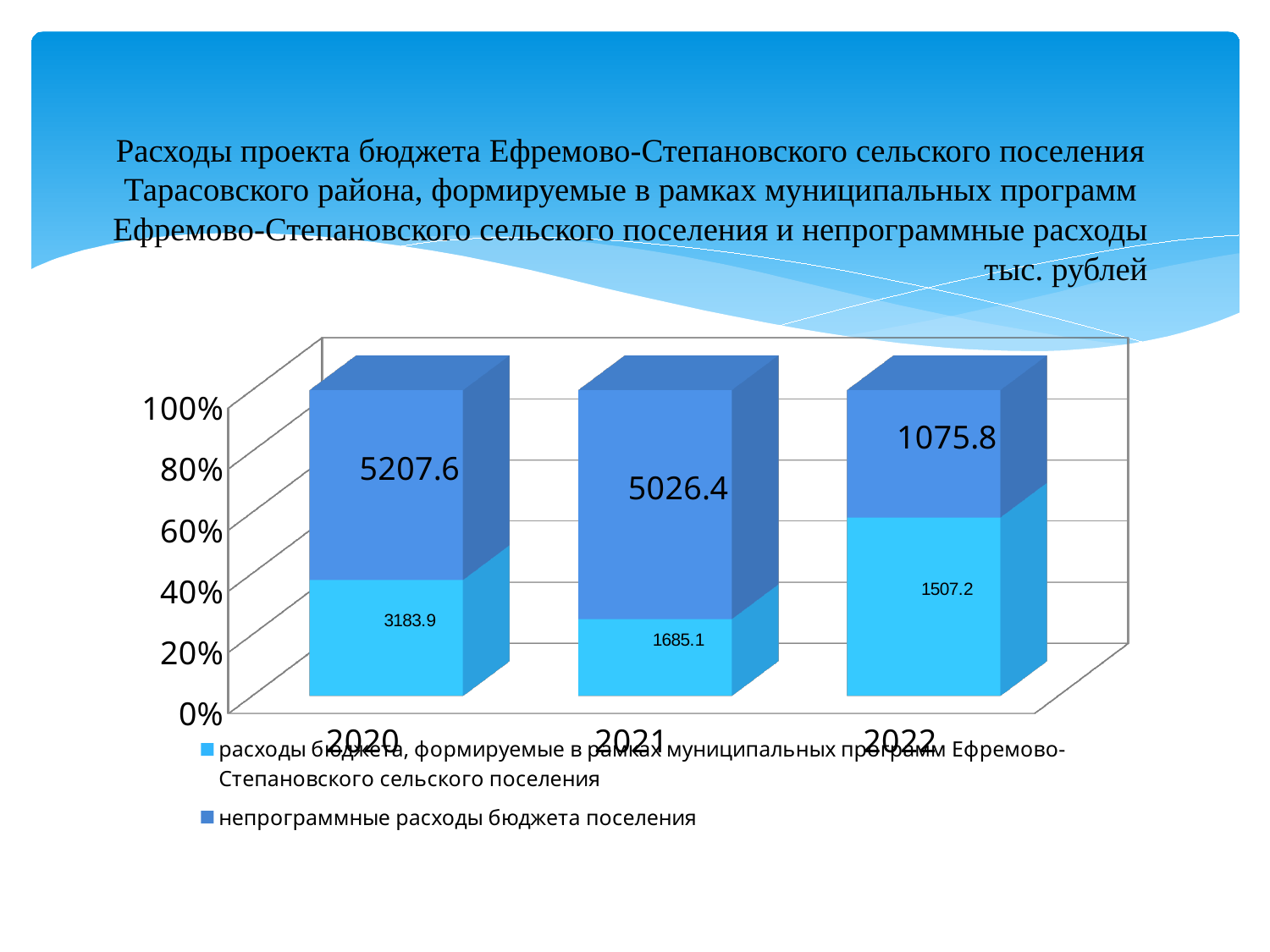
What is the value of the programme-based expenditure (расходы бюджета, формируемые в рамках муниципальных программ) for 2021? 1685.1 What kind of chart is shown on the slide? Stacked bar chart (100%) What is the value of the programme-based expenditure for 2022? 1507.2 How many series does the legend list? 2 In which year is the programme-based expenditure the highest? 2020 How many years are shown on the x axis? 3 What is the value of the non-programme expenditure for 2022? 1075.8 What is the value of the non-programme expenditure (непрограммные расходы бюджета поселения) for 2020? 5207.6 Which is larger in 2022: the programme-based expenditure or the non-programme expenditure? programme-based expenditure (1507.2) In which year is the non-programme expenditure the lowest? 2022 What is the difference between the non-programme expenditure and the programme-based expenditure in 2021? 3341.3 What is the total of the two series for 2020? 8391.5